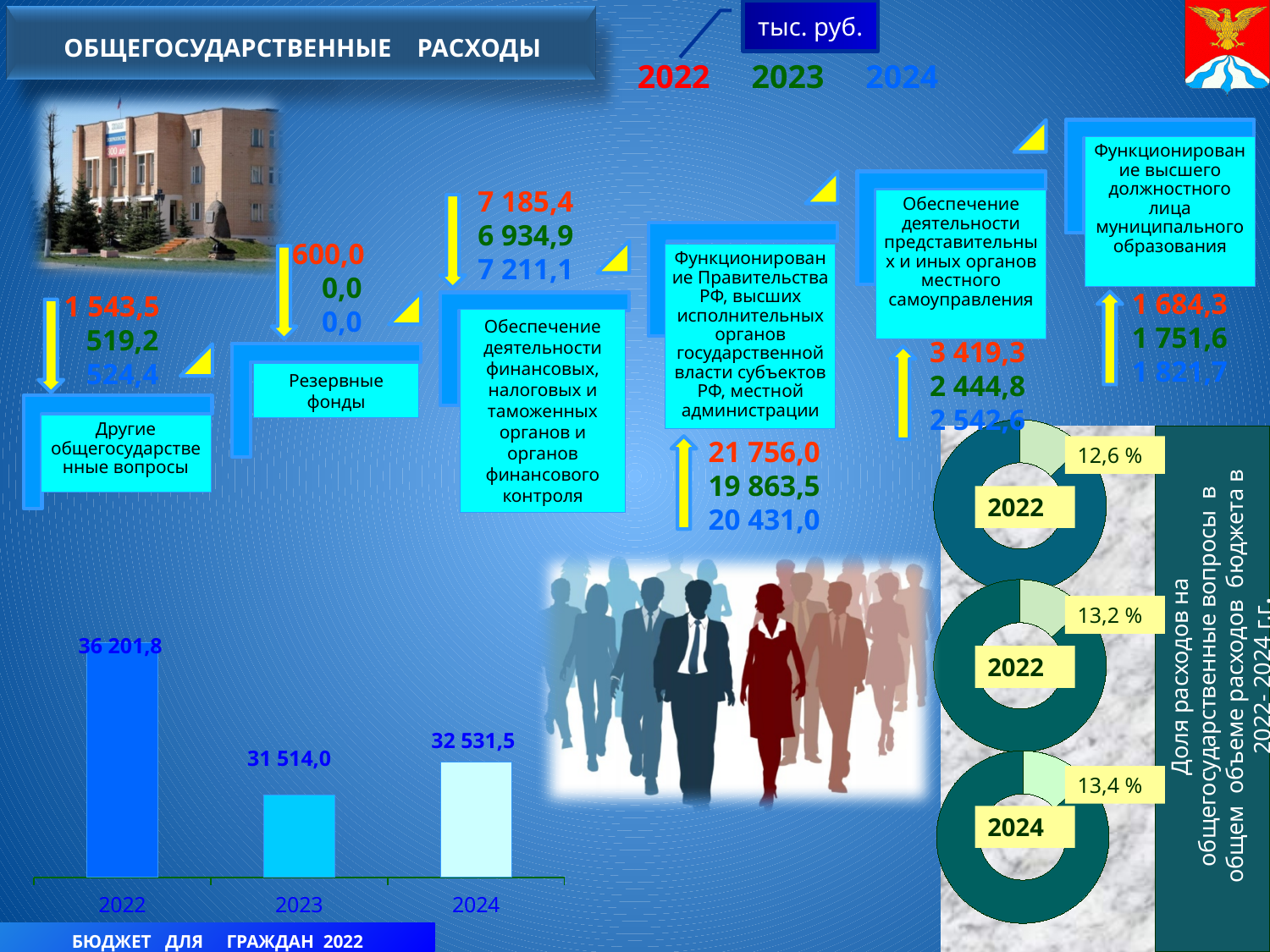
How many bars are in the bar chart at the bottom left? 3 In the bar chart at the bottom left, what is the value for 2024? 32 531,5 In the bar chart at the bottom left, what is the difference between the values for 2024 and 2023? 1 017,5 In the bar chart at the bottom left, which is larger, the value for 2023 or the value for 2024? 2024 In the bar chart at the bottom left, what is the difference between the values for 2022 and 2023? 4 687,8 In the bar chart at the bottom left, which year has the highest value? 2022 What kind of chart is shown at the bottom left of the slide? bar chart In the bar chart at the bottom left, which year has the lowest value? 2023 In the bar chart at the bottom left, what is the value for 2022? 36 201,8 In the bottom donut chart on the right, labelled 2024, what percentage is shown? 13,4 % In the bar chart at the bottom left, what is the value for 2023? 31 514,0 In the top donut chart on the right, labelled 2022, what percentage is shown? 12,6 %